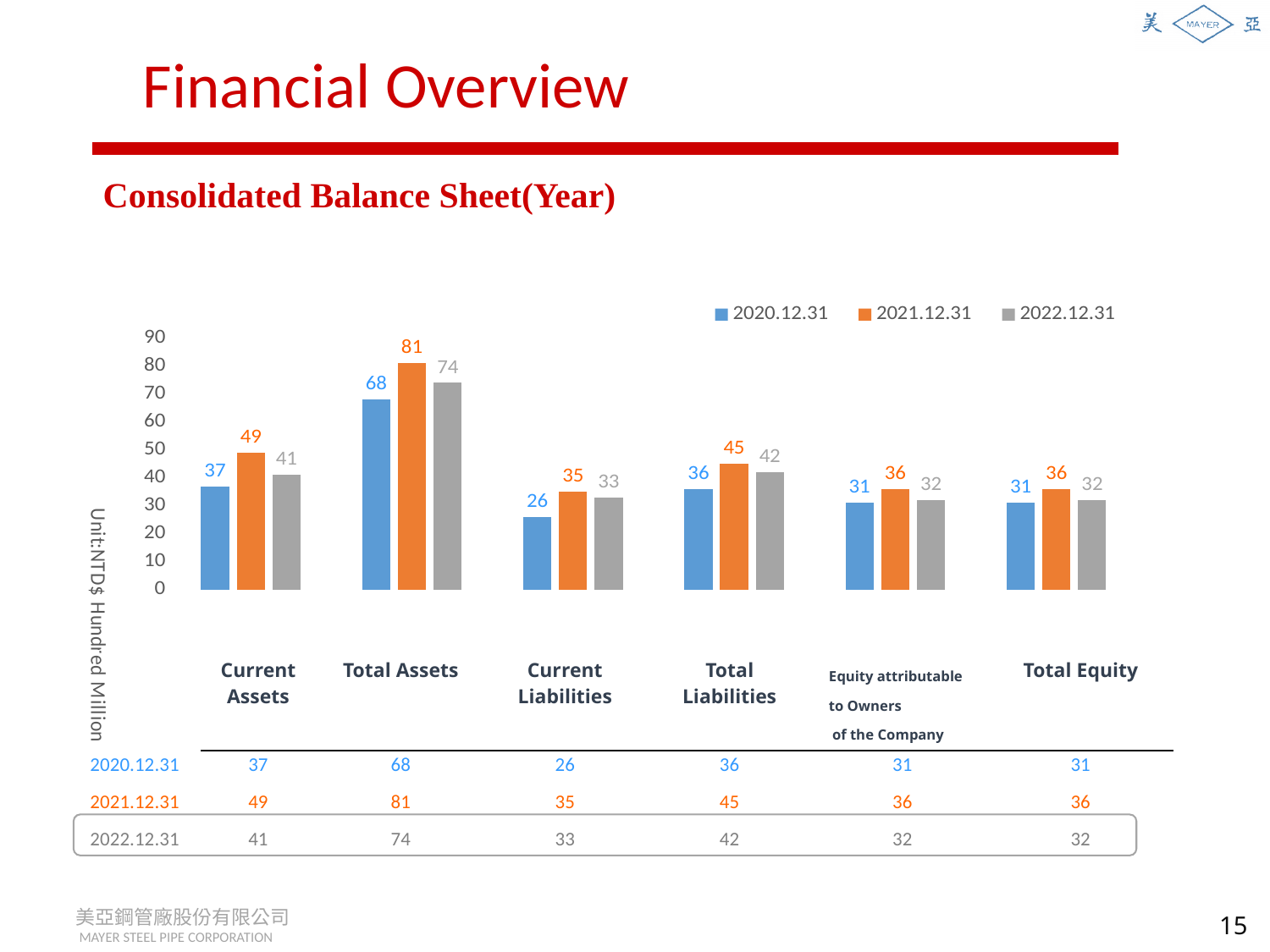
What is the value for Total Liabilities for the 2022.12.31 series? 42 Which category has the lowest value for the 2020.12.31 series? Current Liabilities What is the difference between the 2021.12.31 and 2022.12.31 values for Total Assets? 7 How many categories are shown on the x axis of the chart? 6 What unit is stated on the vertical axis label of the chart? Unit:NTD$ Hundred Million What is the value for Current Liabilities for the 2020.12.31 series? 26 How many series does the legend list? 3 Which category has the highest value for the 2022.12.31 series? Total Assets What kind of chart is shown on the slide? Bar chart Which is larger for Total Liabilities: the 2020.12.31 value or the 2021.12.31 value? 2021.12.31 What is the value for Total Assets for the 2021.12.31 series? 81 What is the difference between the 2021.12.31 and 2020.12.31 values for Current Assets? 12